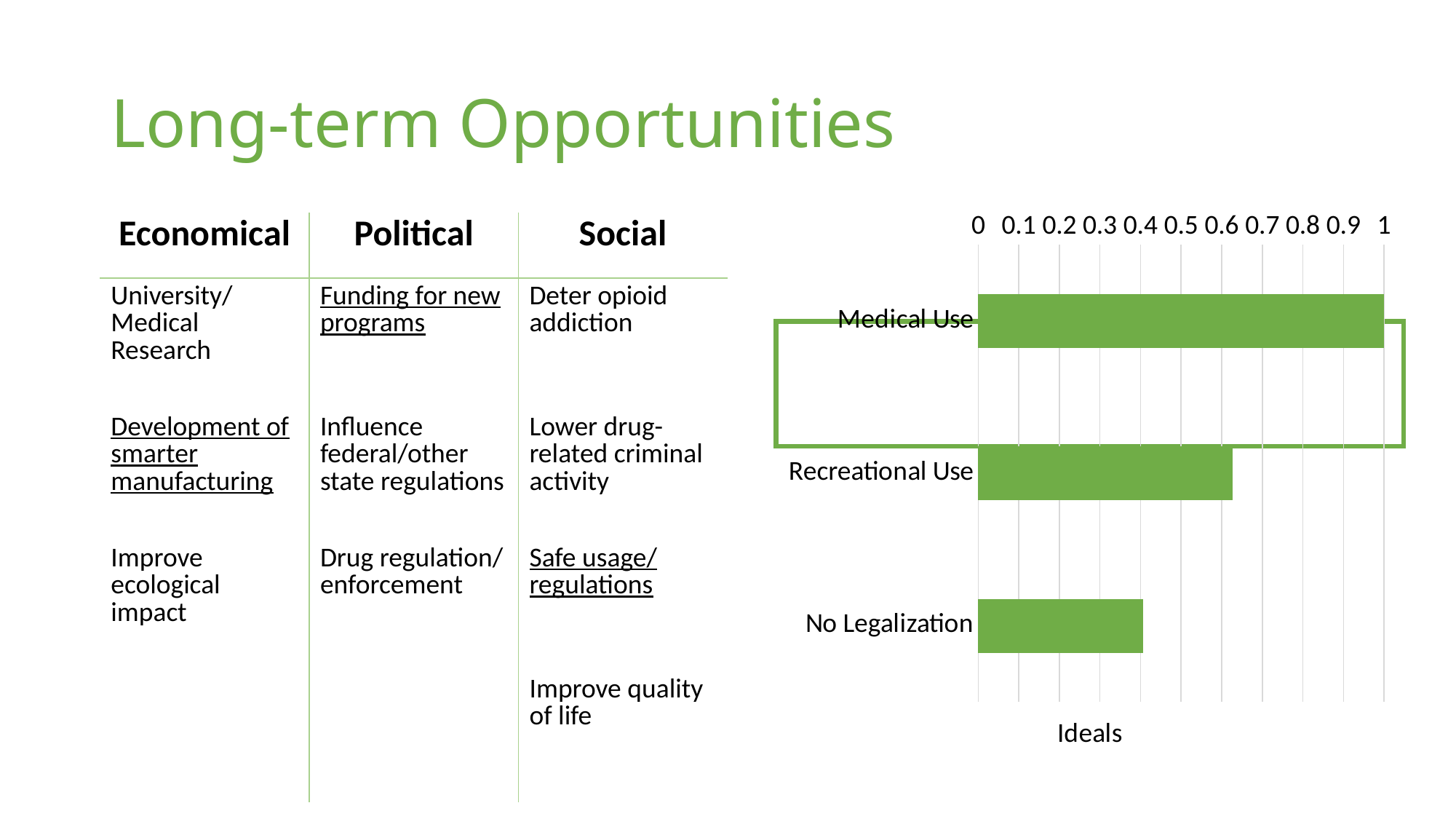
Is the value for No Legalization greater or less than 0.5? less Which has a larger value, Medical Use or Recreational Use? Medical Use What is the title shown below the chart's value axis? Ideals How many categories are plotted in the chart? 3 What is the value for Medical Use in the chart? 1 Which category has the lowest value in the chart? No Legalization Which category has the highest value in the chart? Medical Use Is the value for Recreational Use greater or less than 0.7? less Is the value for Recreational Use greater or less than 0.5? greater What kind of chart is shown on the right side of the slide? bar chart What colour are the bars in the chart? green Which has a larger value, Recreational Use or No Legalization? Recreational Use